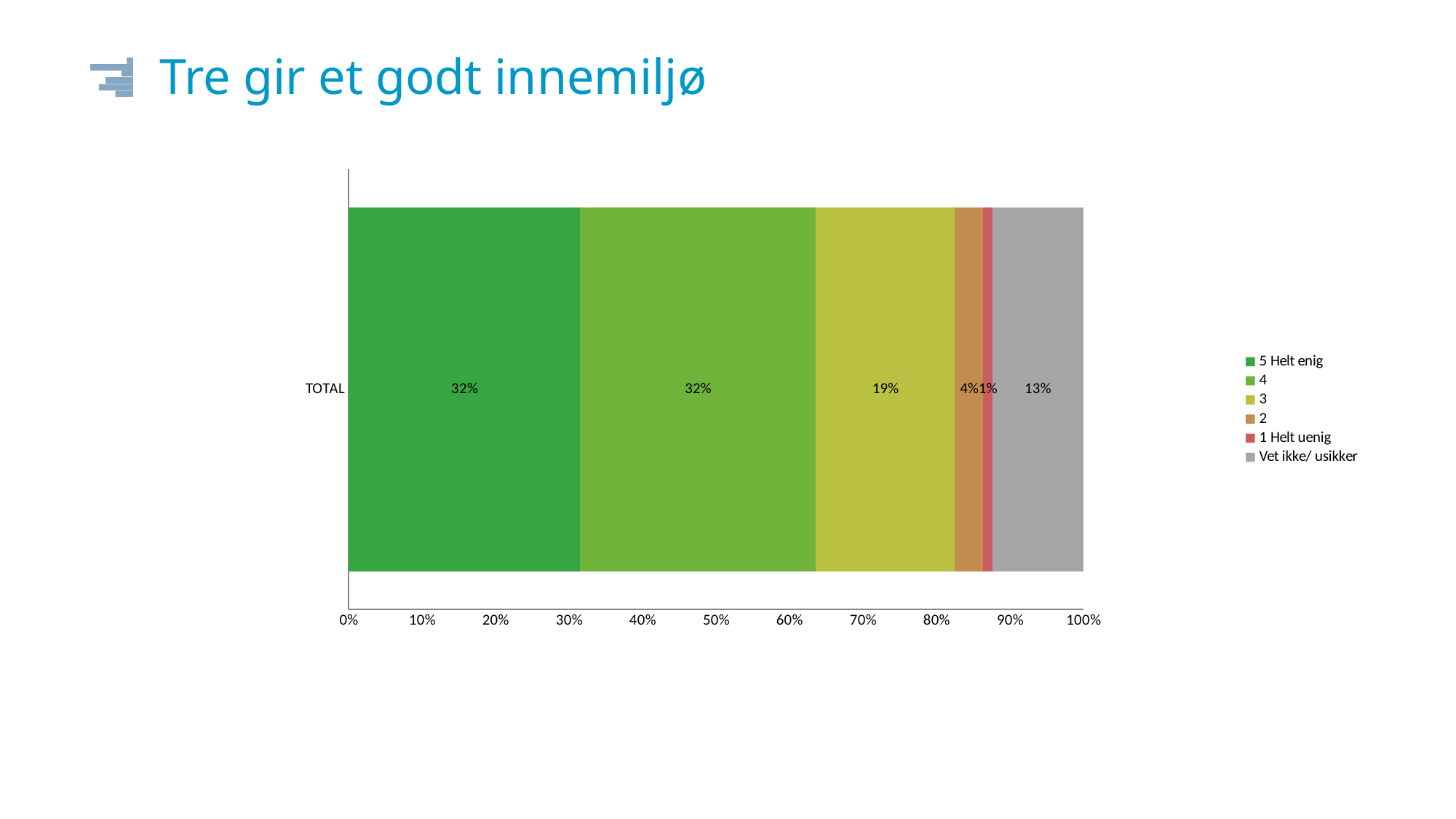
How many series does the legend list? 6 What is the difference between the share for "3" and the share for "Vet ikke/ usikker"? 6% What is the combined share of "5 Helt enig" and "4" in the TOTAL bar? 64% What percentage of respondents answered "2" for TOTAL? 4% Which is larger: the share for "3" or the share for "Vet ikke/ usikker"? 3 Which response category has the smallest share in the TOTAL bar? 1 Helt uenig What is the title of the slide containing the chart? Tre gir et godt innemiljø What percentage of respondents answered "Vet ikke/ usikker" for TOTAL? 13% What kind of chart is shown on the slide? Stacked bar chart What percentage of respondents answered "1 Helt uenig" for TOTAL? 1% What percentage of respondents answered "5 Helt enig" for TOTAL? 32% What percentage of respondents answered "3" for TOTAL? 19%